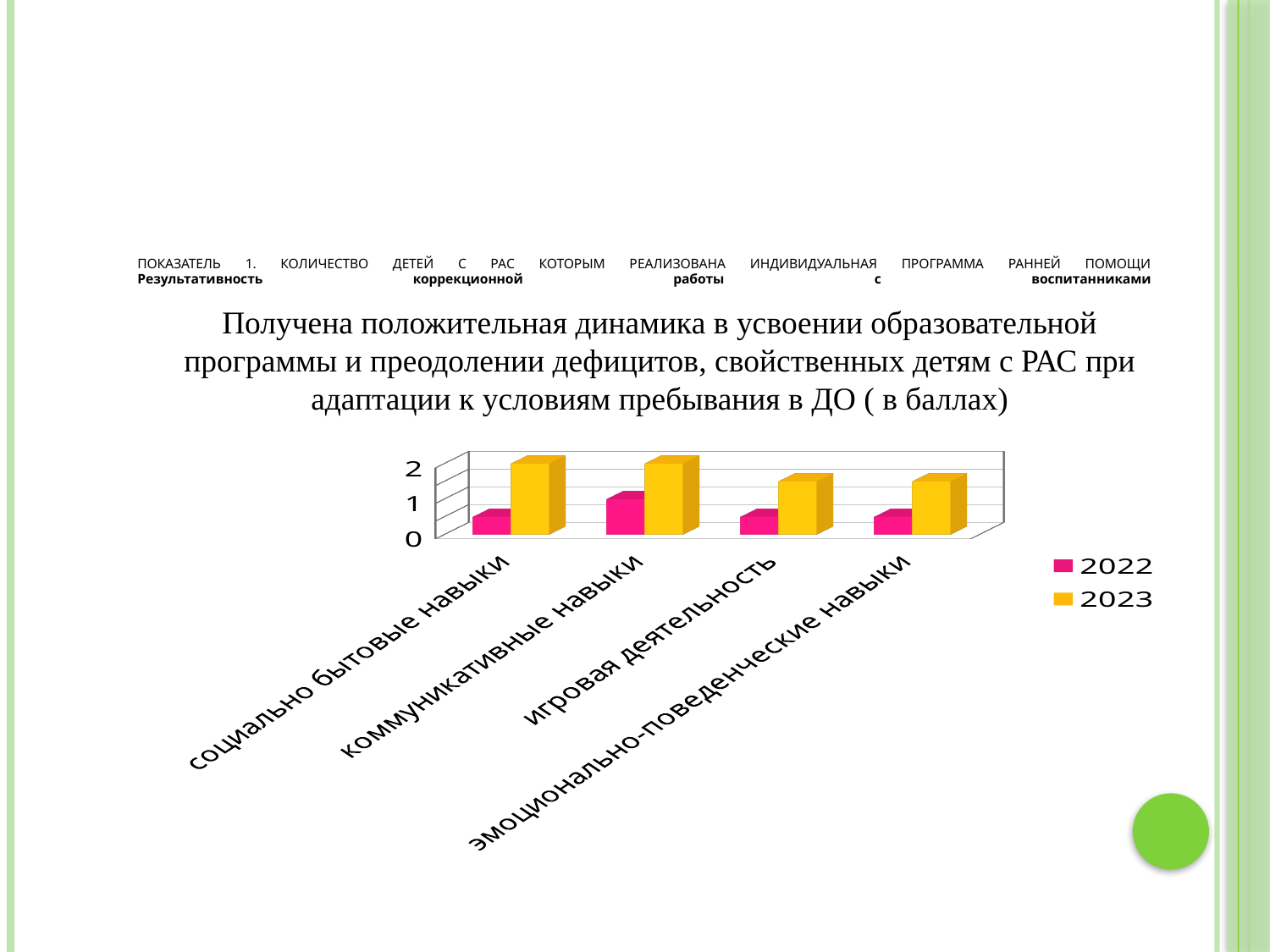
Is the 2023 value for 'игровая деятельность' greater or less than 1? greater How many series does the chart legend list? 2 For 'эмоционально-поведенческие навыки', which series has the larger value, 2022 or 2023? 2023 Is the 2022 value for 'социально бытовые навыки' greater or less than 1? less How many categories are shown on the x axis of the chart? 4 What colour are the bars for the 2023 series? yellow What kind of chart is shown on the slide? bar chart For 'игровая деятельность', which series has the larger value, 2022 or 2023? 2023 Among the 2022 bars, which category has the highest value? коммуникативные навыки For 'социально бытовые навыки', which series has the larger value, 2022 or 2023? 2023 Is the 2023 value for 'социально бытовые навыки' greater or less than 1? greater Which years are listed in the chart legend? 2022 and 2023